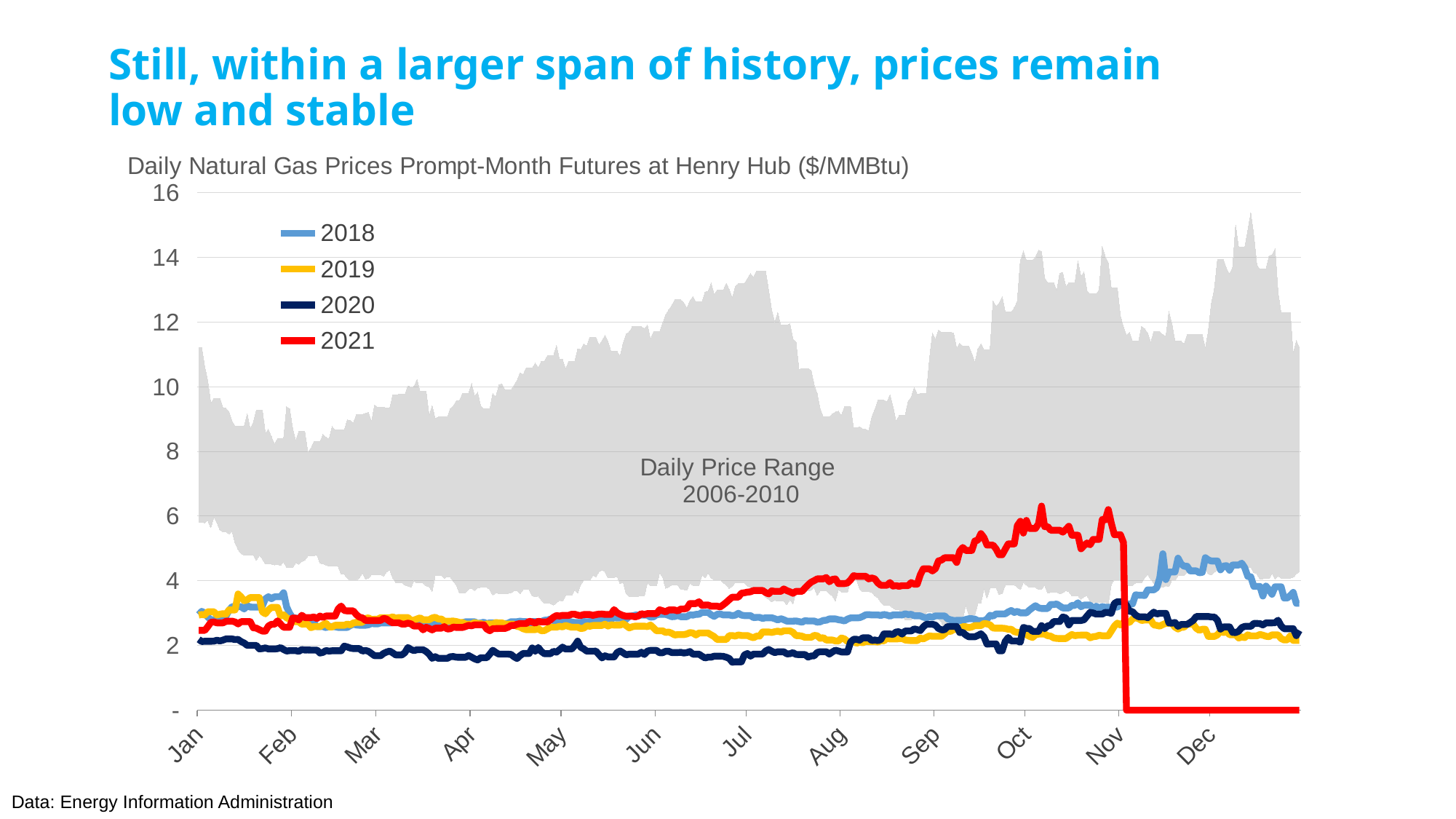
Is the value of the 2018 line in early December greater or less than 4? greater What is the title of the chart? Daily Natural Gas Prices Prompt-Month Futures at Henry Hub ($/MMBtu) What kind of chart is shown on the slide? line chart Is the value of the 2021 line in early October greater or less than 4? greater Is the value of the 2020 line in April greater or less than 2? less Does the 2021 line rise or fall from January to early October? rise How many month labels are shown on the x axis? 12 How many series does the legend list? 4 What period does the shaded grey area labelled 'Daily Price Range' cover? 2006-2010 Which series has the highest value in October? 2021 In April, which is larger: the 2020 line or the 2021 line? 2021